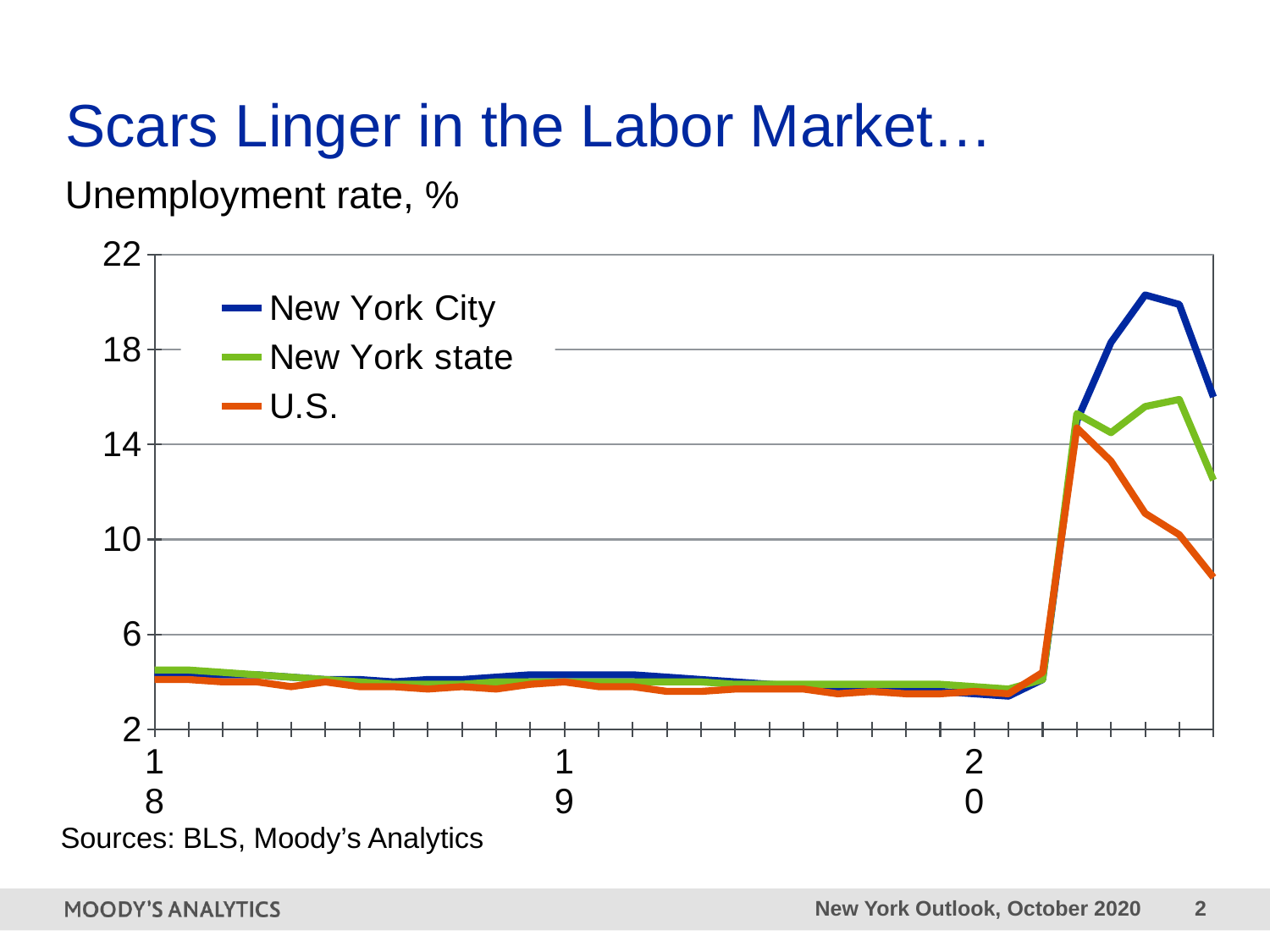
Is the peak value for U.S. greater or less than 10? greater How many series does the legend list? 3 What kind of chart is shown on the slide? Line chart Which series reaches the highest peak in 2020? New York City Which series has the lowest value at the last plotted point? U.S. What unit or measure is stated below the chart title? Unemployment rate, % Is the peak value for New York City greater or less than 18? greater Is the value for New York City at the start of 2018 greater or less than 6? less After its 2020 peak, does the U.S. line rise or fall? fall What colour is the U.S. line in the chart? Orange At the last plotted point, is New York City higher or lower than New York state? higher